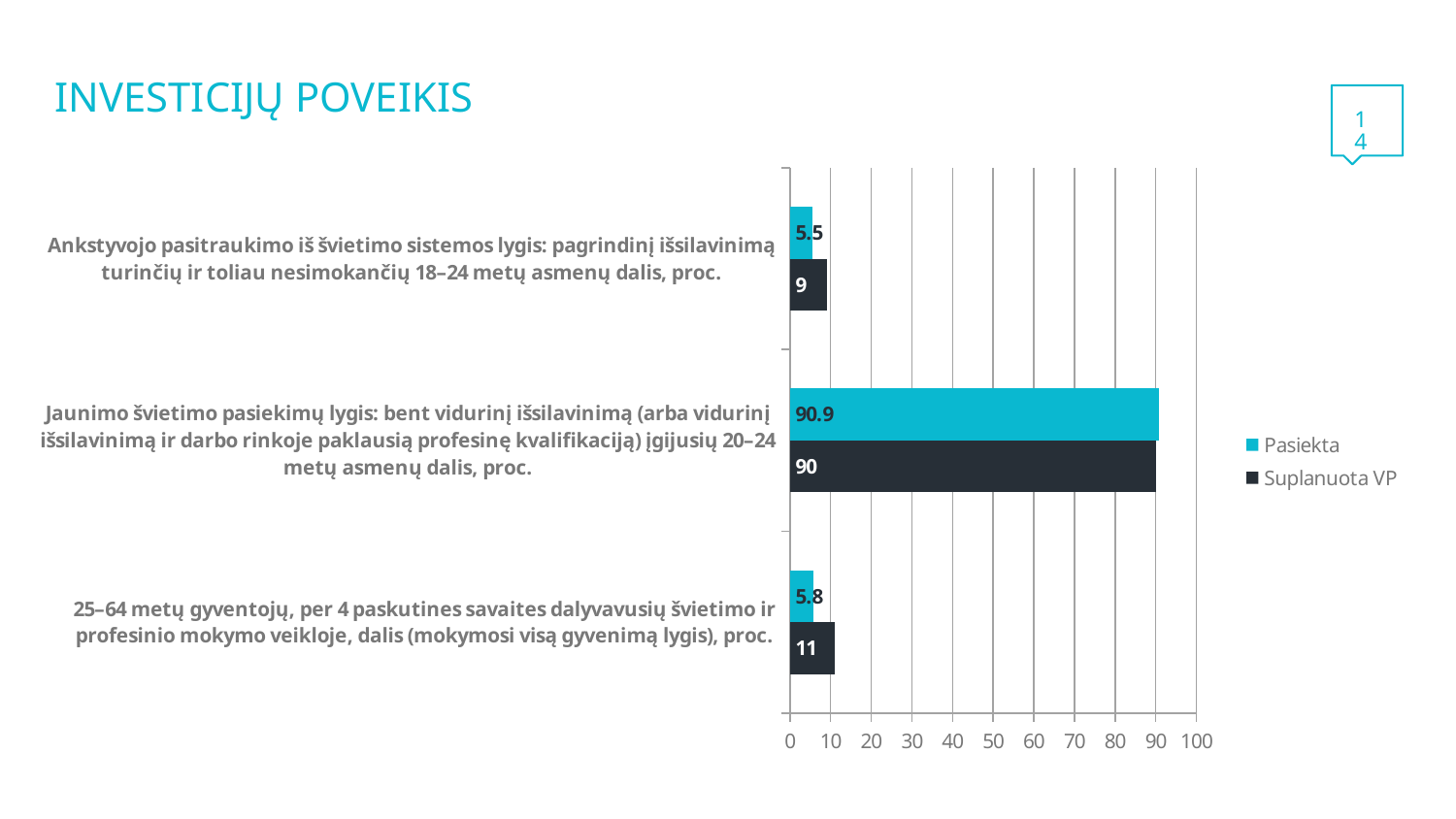
Which category has the lowest Suplanuota VP value? Ankstyvojo pasitraukimo iš švietimo sistemos lygis Which category has the highest Pasiekta value? Jaunimo švietimo pasiekimų lygis What is the Pasiekta value for the category 'Jaunimo švietimo pasiekimų lygis'? 90.9 For the category 'Jaunimo švietimo pasiekimų lygis', which is larger: the Pasiekta value or the Suplanuota VP value? Pasiekta How many series does the legend list? 2 What is the difference between the Suplanuota VP value and the Pasiekta value for the category '25–64 metų gyventojų' (mokymosi visą gyvenimą lygis)? 5.2 What kind of chart is shown on the slide? Bar chart How many categories are shown on the chart? 3 What is the Suplanuota VP value for the category 'Ankstyvojo pasitraukimo iš švietimo sistemos lygis'? 9 What is the Suplanuota VP value for the category '25–64 metų gyventojų, per 4 paskutines savaites dalyvavusių švietimo ir profesinio mokymo veikloje, dalis'? 11 What is the Pasiekta value for the category 'Ankstyvojo pasitraukimo iš švietimo sistemos lygis'? 5.5 Which series is shown in dark (black) bars? Suplanuota VP